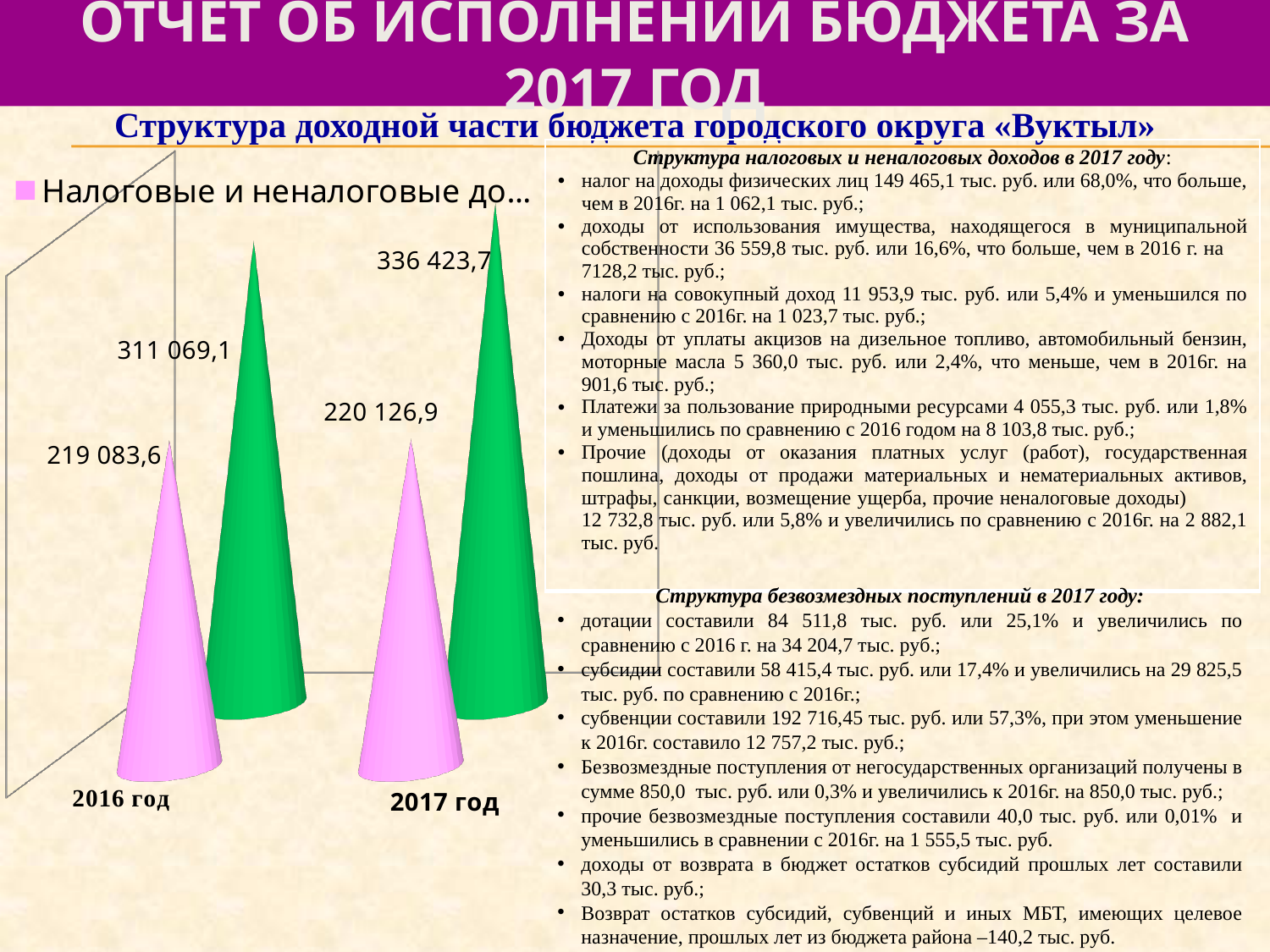
What kind of chart is shown on the slide? bar chart What is the value of the green series for 2017 год? 336 423,7 What is the value of the green series for 2016 год? 311 069,1 Which year has the higher value for the green series? 2017 год By how much did the pink series (Налоговые и неналоговые доходы) increase from 2016 год to 2017 год? 1 043,3 What is the difference between the green and pink values in 2016 год? 91 985,5 In 2017 год, which is larger: the pink series or the green series? the green series Does the green series rise or fall from 2016 год to 2017 год? rise What is the value of the pink series (Налоговые и неналоговые доходы) for 2017 год? 220 126,9 How many years (categories) are shown on the x axis of the chart? 2 By how much did the green series increase from 2016 год to 2017 год? 25 354,6 What is the value of the pink series (Налоговые и неналоговые доходы) for 2016 год? 219 083,6